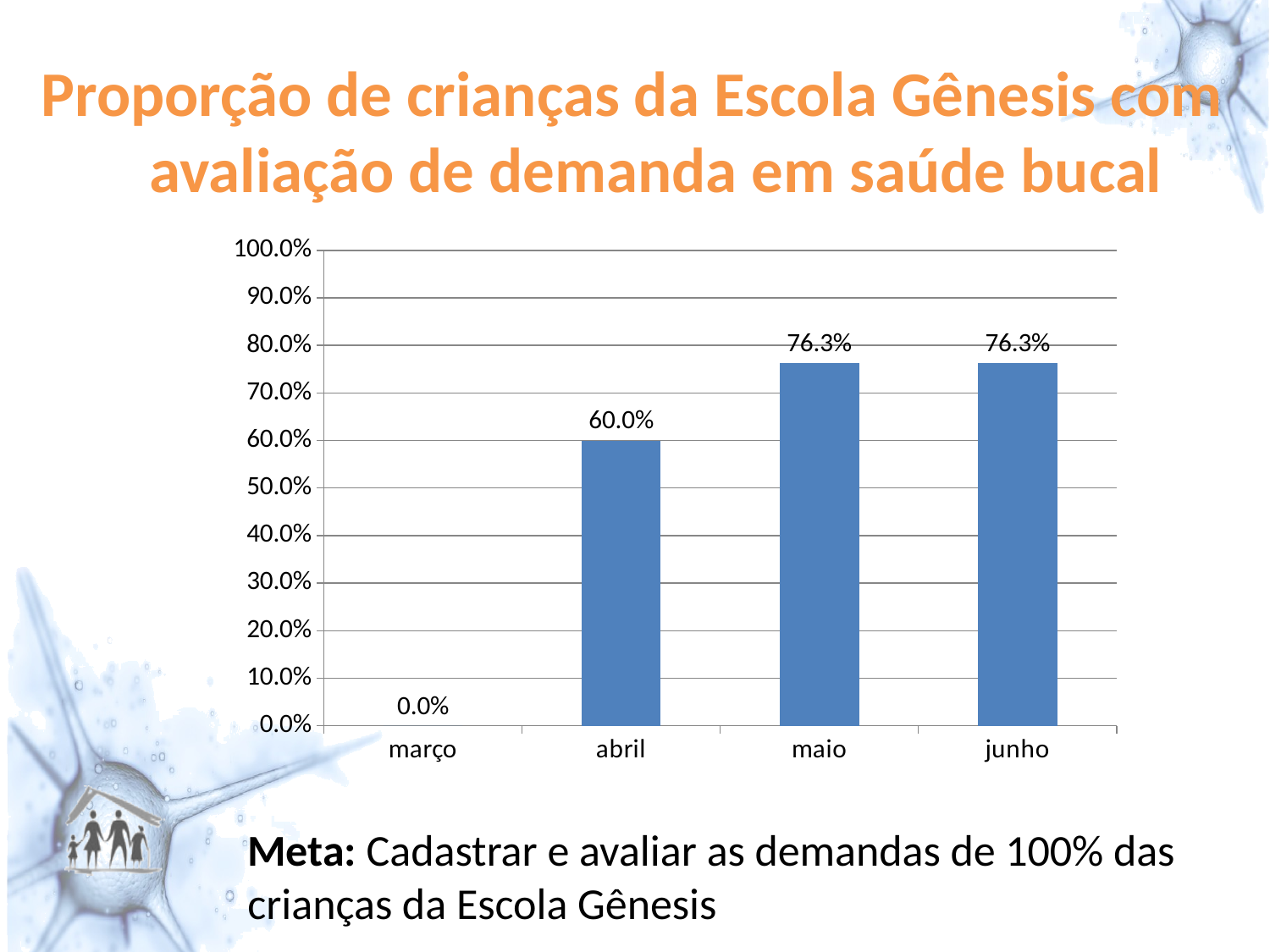
What is the difference between the values for maio and abril? 16.3% Is the value for junho greater or less than 80.0%? less Do the values rise or fall from março to maio? rise Is the value for abril greater or less than 50.0%? greater What is the value for março? 0.0% What kind of chart is shown on the slide? bar chart What is the value for abril? 60.0% What is the highest value shown on the y axis? 100.0% How many months are shown on the x axis? 4 Which is larger, the value for abril or the value for junho? junho What is the value for maio? 76.3% Which month has the lowest value? março